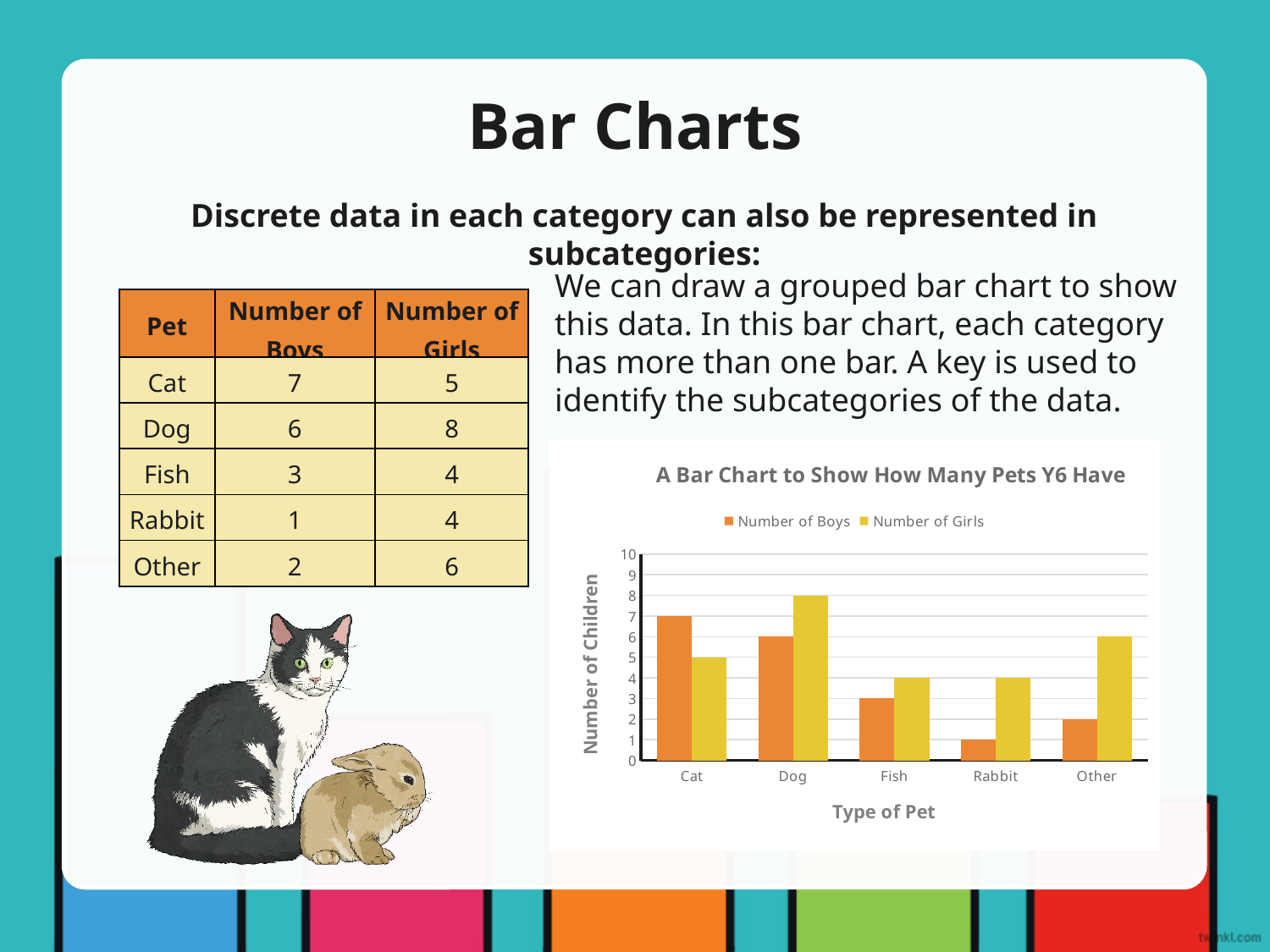
What type of chart is shown on the slide? bar chart What is the Number of Boys value for Rabbit in the chart? 1 Which type of pet has the lowest Number of Boys in the chart? Rabbit What is the Number of Boys value for Dog in the chart? 6 For Cat, which is larger in the chart: Number of Boys or Number of Girls? Number of Boys Which type of pet has the highest Number of Girls in the chart? Dog What is the difference between the Number of Girls and the Number of Boys for Rabbit in the chart? 3 What is the title of the chart? A Bar Chart to Show How Many Pets Y6 Have What is the Number of Girls value for Other in the chart? 6 How many types of pet are shown on the x axis of the chart? 5 How many series does the chart's legend list? 2 Is the Number of Girls value for Dog greater or less than 5? greater